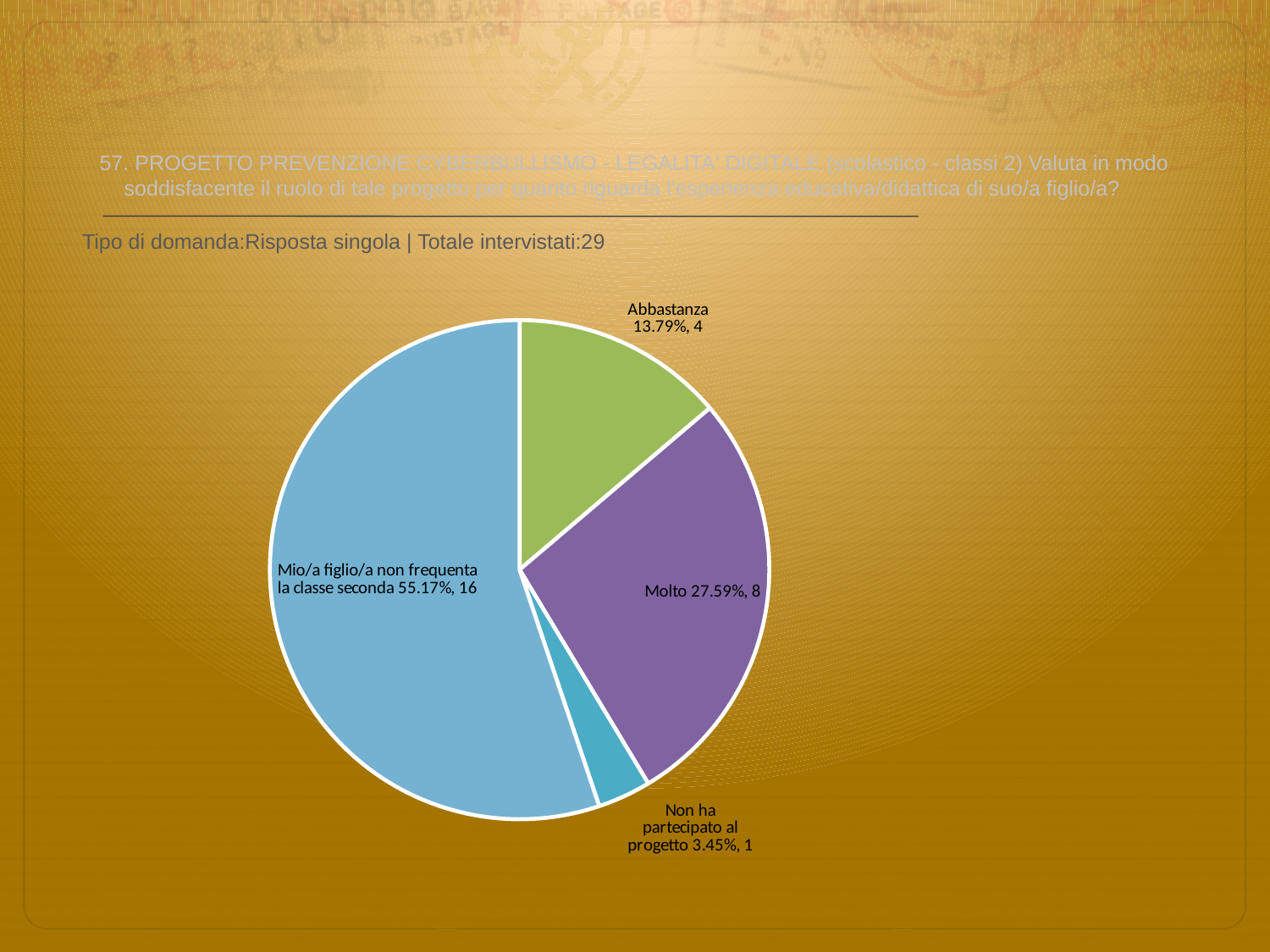
What percentage share does the 'Molto' slice have? 27.59% Which category has the largest slice? Mio/a figlio/a non frequenta la classe seconda What is the count for 'Mio/a figlio/a non frequenta la classe seconda'? 16 Which category has the smallest slice? Non ha partecipato al progetto How many slices does the pie chart have? 4 What colour is the 'Molto' slice? purple What is the total number of respondents (Totale intervistati) stated on the slide? 29 What percentage share does the 'Non ha partecipato al progetto' slice have? 3.45% What kind of chart is shown on the slide? pie chart How many respondents answered 'Abbastanza'? 4 What is the difference in count between 'Molto' and 'Abbastanza'? 4 Which is larger, the 'Molto' slice or the 'Abbastanza' slice? Molto